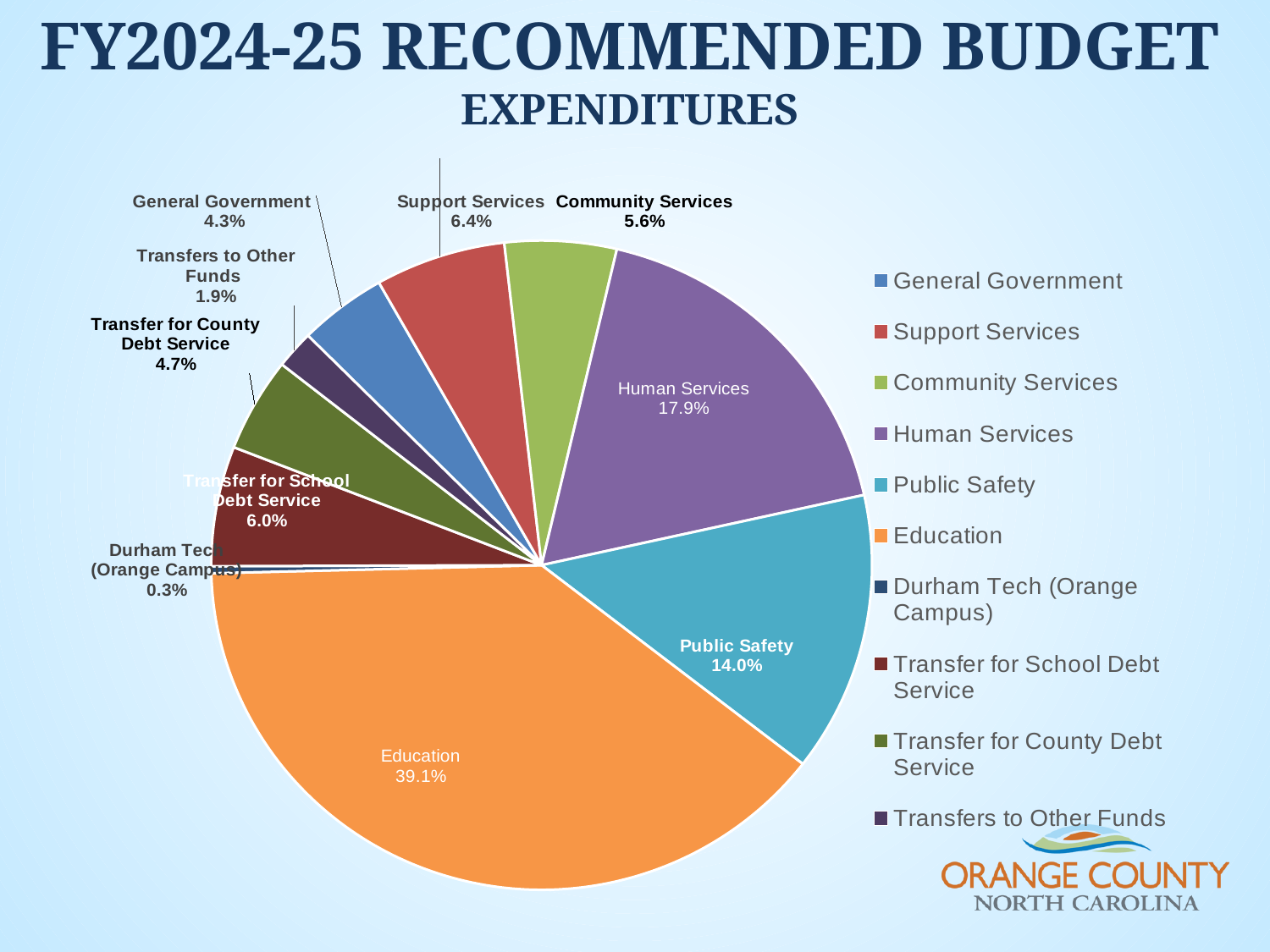
What is the difference in percentage points between Education and Human Services? 21.2 Which is larger, Support Services or Community Services? Support Services What percentage is shown for Transfer for County Debt Service? 4.7% Which category has the smallest share of expenditures? Durham Tech (Orange Campus) How many categories does the legend list? 10 Which category has the largest share of expenditures? Education What colour is the Education slice? Orange What share of expenditures goes to Education? 39.1% What percentage of expenditures is Human Services? 17.9% What is the combined share of Transfer for School Debt Service and Transfer for County Debt Service? 10.7% What is the value for Public Safety? 14.0% What kind of chart is shown on the slide? Pie chart